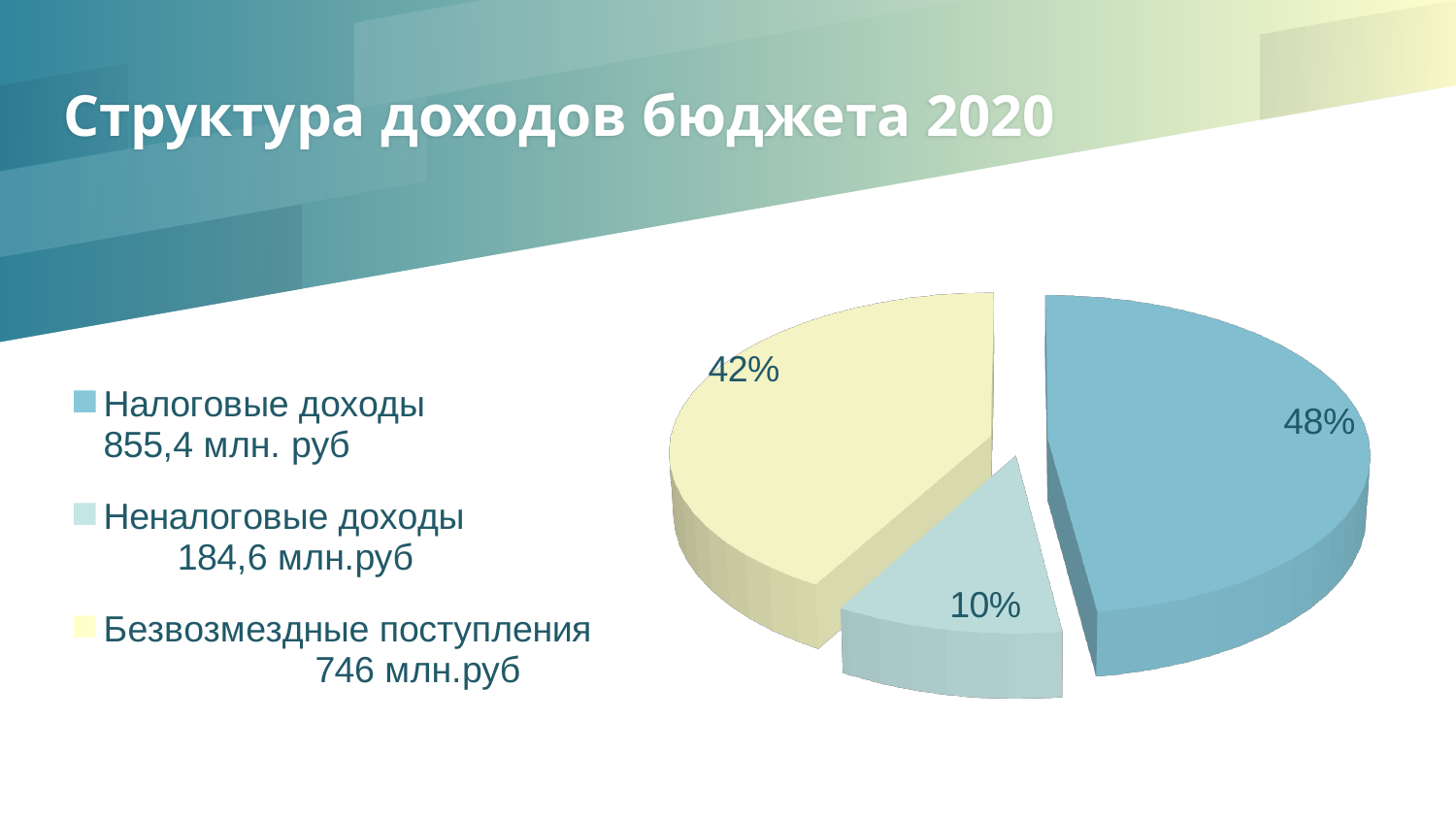
According to the legend, what amount in млн. руб corresponds to Безвозмездные поступления? 746 млн.руб What is the title of the chart on the slide? Структура доходов бюджета 2020 Which category has the largest slice of the pie? Налоговые доходы What is the difference in percentage points between the Налоговые доходы slice and the Безвозмездные поступления slice? 6% What share of the pie does Безвозмездные поступления represent? 42% What share of the pie does Неналоговые доходы represent? 10% What share of the pie does Налоговые доходы represent? 48% How many slices does the pie chart have? 3 Which category has the smallest slice of the pie? Неналоговые доходы Which slice is larger: Безвозмездные поступления or Неналоговые доходы? Безвозмездные поступления According to the legend, what amount in млн. руб corresponds to Неналоговые доходы? 184,6 млн.руб What kind of chart is shown on the slide? Pie chart